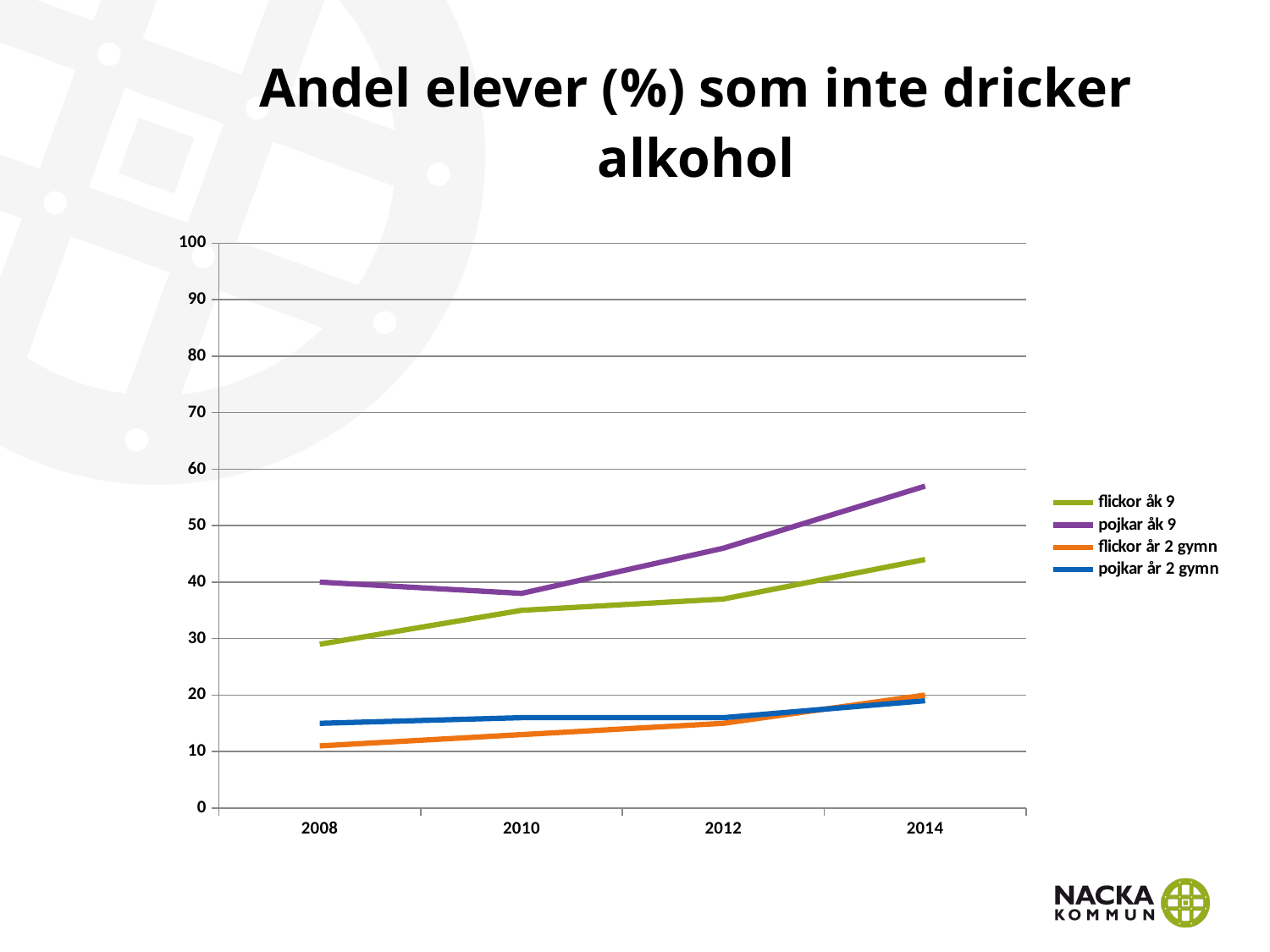
In 2014, which is larger: the value for pojkar åk 9 or the value for flickor åk 9? pojkar åk 9 Is the value for flickor åk 9 in 2008 greater or less than 40? less Which series has the lowest value in 2008? flickor år 2 gymn How many years are shown on the x axis? 4 Does the value for flickor åk 9 rise or fall from 2008 to 2014? rise Is the value for pojkar åk 9 in 2008 greater or less than 30? greater What kind of chart is shown on the slide? line chart How many series does the legend list? 4 Is the value for pojkar åk 9 in 2014 greater or less than 50? greater Which series has the highest value in 2014? pojkar åk 9 What is the title of the chart? Andel elever (%) som inte dricker alkohol